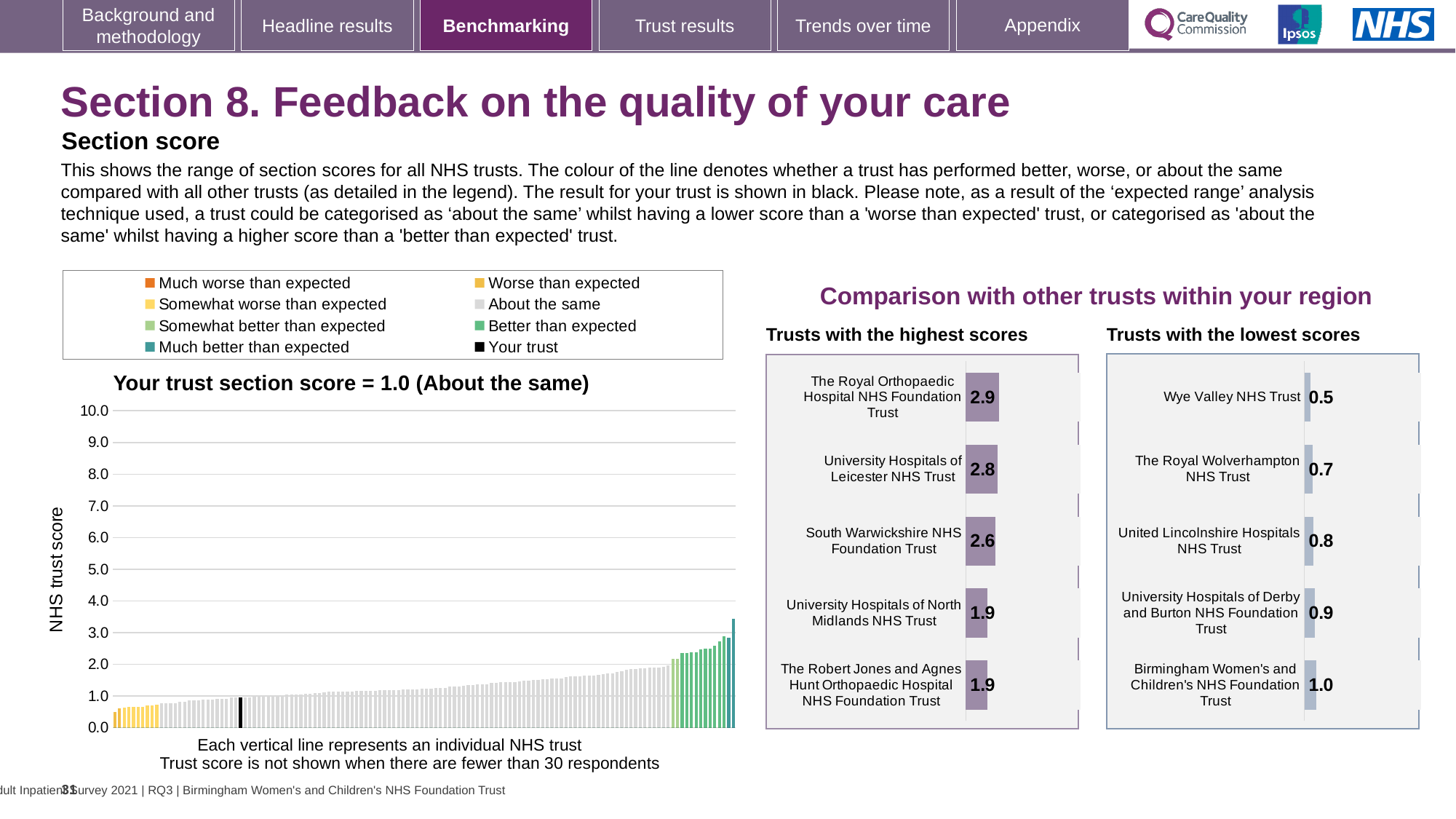
In the 'Trusts with the lowest scores' chart, what is the difference between the scores of Birmingham Women's and Children's NHS Foundation Trust and Wye Valley NHS Trust? 0.5 What is the y-axis label of the 'Your trust section score' chart? NHS trust score In the 'Trusts with the highest scores' chart, which trust has the highest score? The Royal Orthopaedic Hospital NHS Foundation Trust How many entries does the legend above the 'Your trust section score' chart list? 8 In the 'Trusts with the highest scores' chart, what is the difference between the scores of The Royal Orthopaedic Hospital NHS Foundation Trust and South Warwickshire NHS Foundation Trust? 0.3 In the 'Trusts with the highest scores' chart, which has the larger score: University Hospitals of Leicester NHS Trust or South Warwickshire NHS Foundation Trust? University Hospitals of Leicester NHS Trust In the 'Trusts with the lowest scores' chart, which trust has the lowest score? Wye Valley NHS Trust In the 'Your trust section score' chart, is the value of the tallest bar greater or less than 3.0? greater In the 'Trusts with the highest scores' chart, what is the score for The Royal Orthopaedic Hospital NHS Foundation Trust? 2.9 What kind of chart is the 'Your trust section score' chart on the left? Bar chart In the 'Trusts with the lowest scores' chart, what is the score for United Lincolnshire Hospitals NHS Trust? 0.8 How many trusts are listed in the 'Trusts with the highest scores' chart? 5